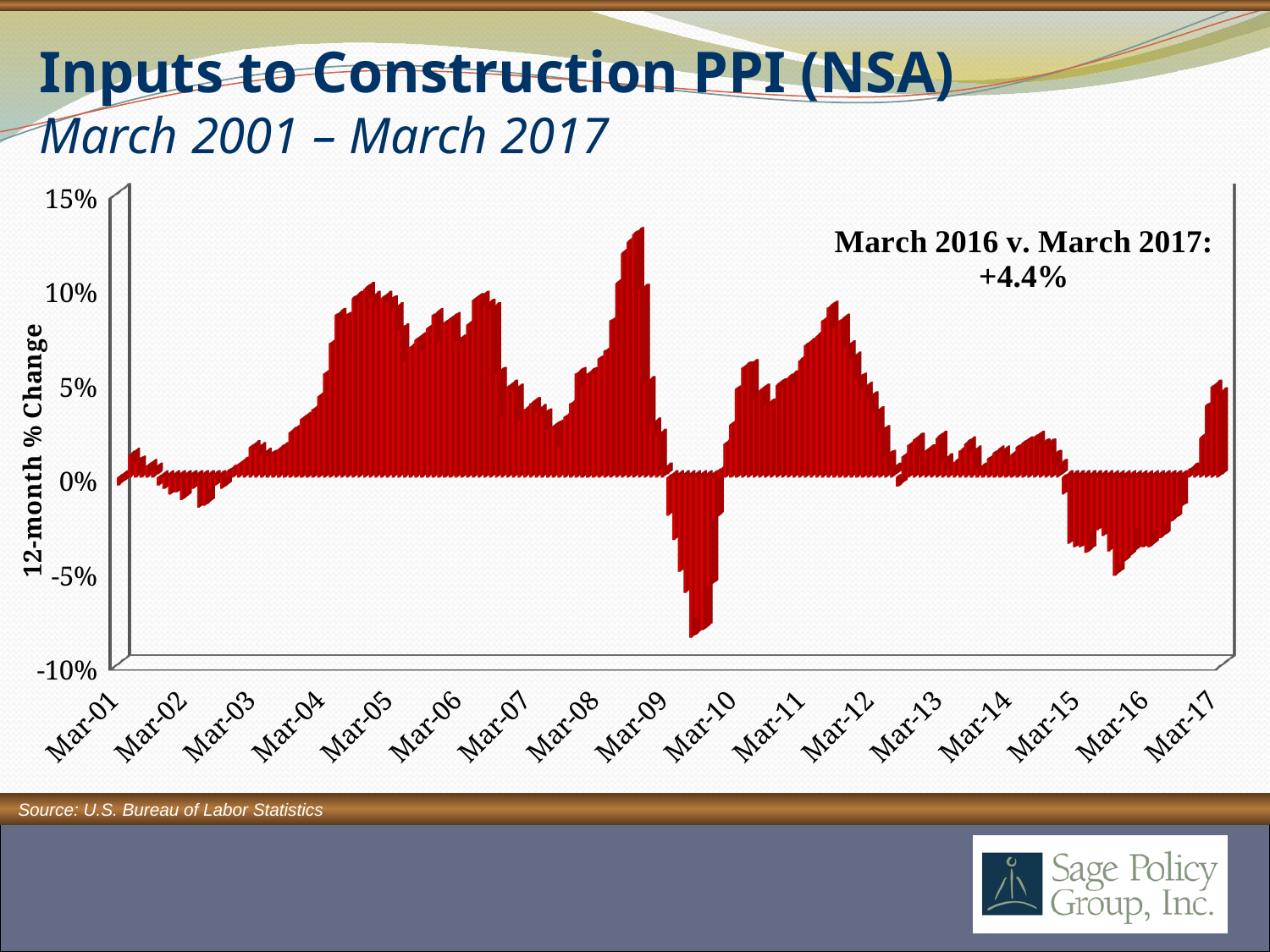
Is the lowest value on the chart greater or less than -5%? less Do the values rise or fall between Mar-16 and Mar-17? rise What is the title of the vertical axis? 12-month % Change What is the 12-month percent change for March 2016 v. March 2017 shown in the annotation? +4.4% Is the value for Mar-16 greater or less than 0%? less Is the value for Mar-05 greater or less than 5%? greater How many year labels are shown on the x axis? 17 Which is larger, the value for Mar-05 or the value for Mar-14? Mar-05 What kind of chart is shown on the slide? Bar chart